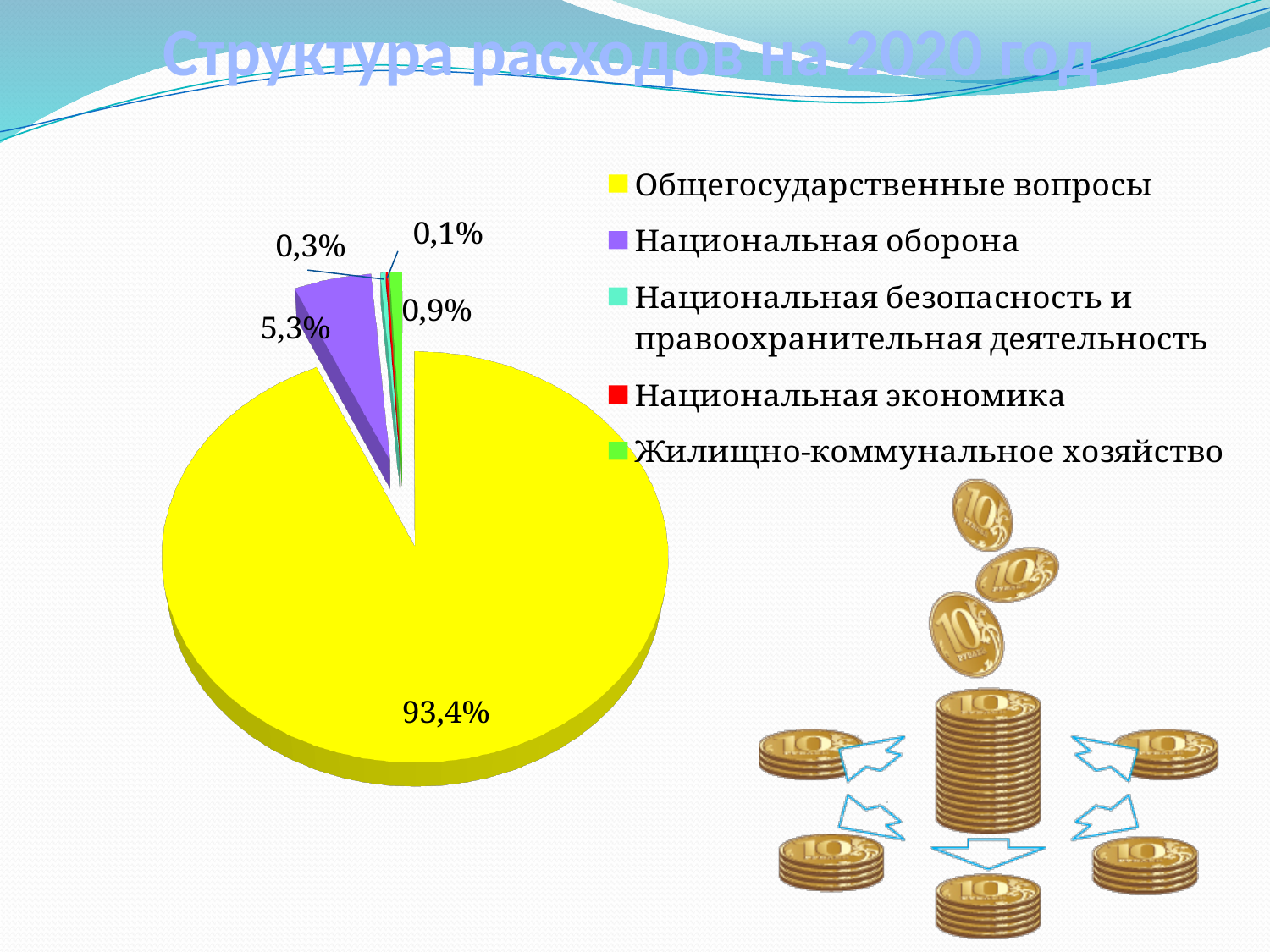
What kind of chart is shown on the slide? pie chart Which is larger: the share for Национальная оборона or the share for Жилищно-коммунальное хозяйство? Национальная оборона Which category has the largest share of expenditures? Общегосударственные вопросы What is the difference in percentage points between Общегосударственные вопросы and Национальная оборона? 88,1% What is the title of the chart? Структура расходов на 2020 год How many entries does the legend list? 5 What colour is the slice for Национальная оборона? purple What share of expenditures goes to Жилищно-коммунальное хозяйство? 0,9% What share of expenditures goes to Национальная оборона? 5,3% How many slices does the pie chart have? 5 Which category has the smallest share of expenditures? Национальная экономика What share of expenditures goes to Общегосударственные вопросы? 93,4%